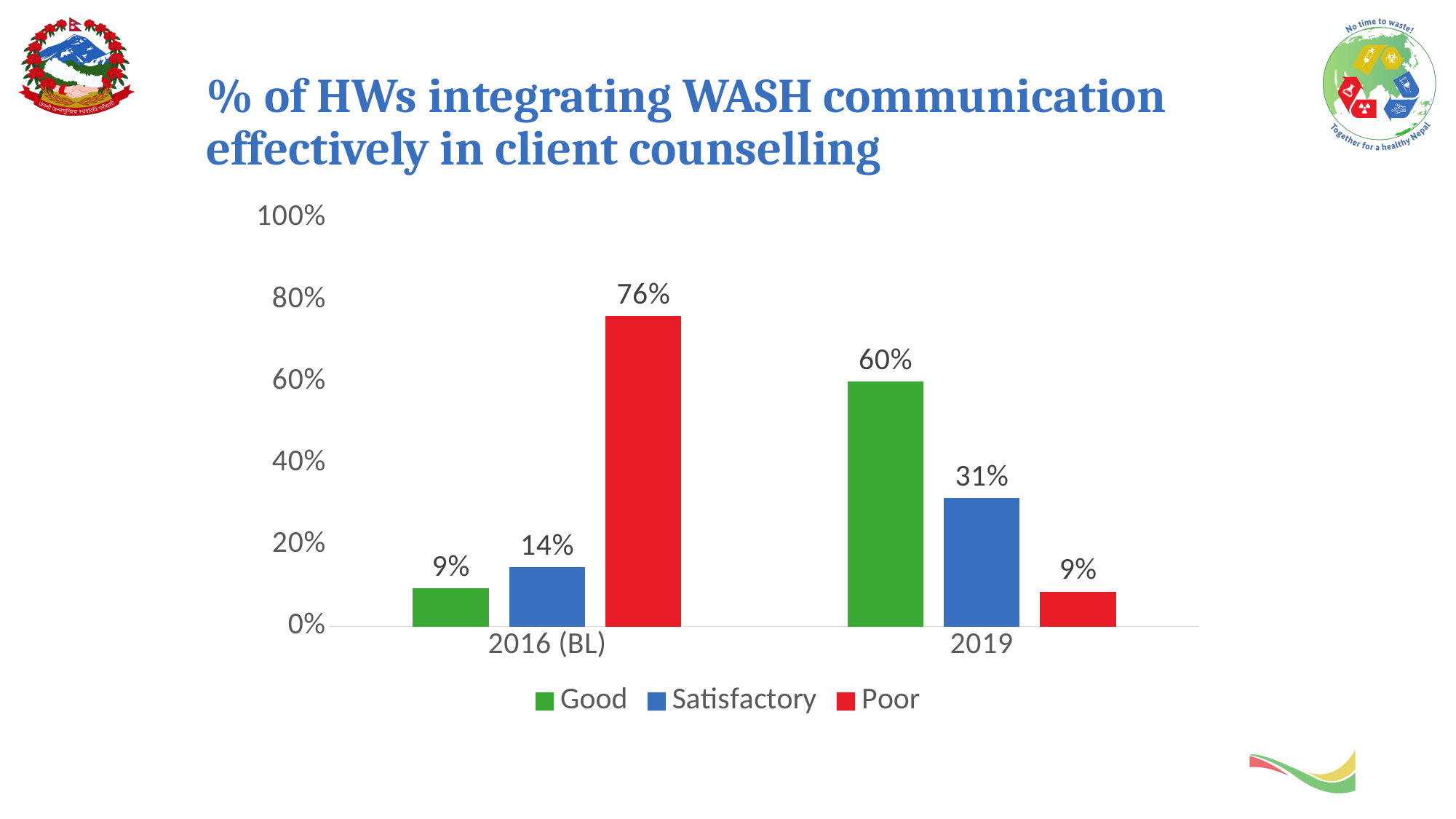
Which series has the lowest value in 2019? Poor How many series does the legend list? 3 What is the difference between the Good value in 2019 and the Good value in 2016 (BL)? 51% What is the value for Poor in 2016 (BL)? 76% Does the Good value rise or fall from 2016 (BL) to 2019? Rise What is the value for Satisfactory in 2019? 31% What is the value for Satisfactory in 2016 (BL)? 14% Which is larger: Poor in 2016 (BL) or Poor in 2019? Poor in 2016 (BL) What kind of chart is shown on the slide? Bar chart Is the value for Good in 2019 greater or less than 40%? greater Which series has the highest value in 2016 (BL)? Poor What is the value for Good in 2019? 60%